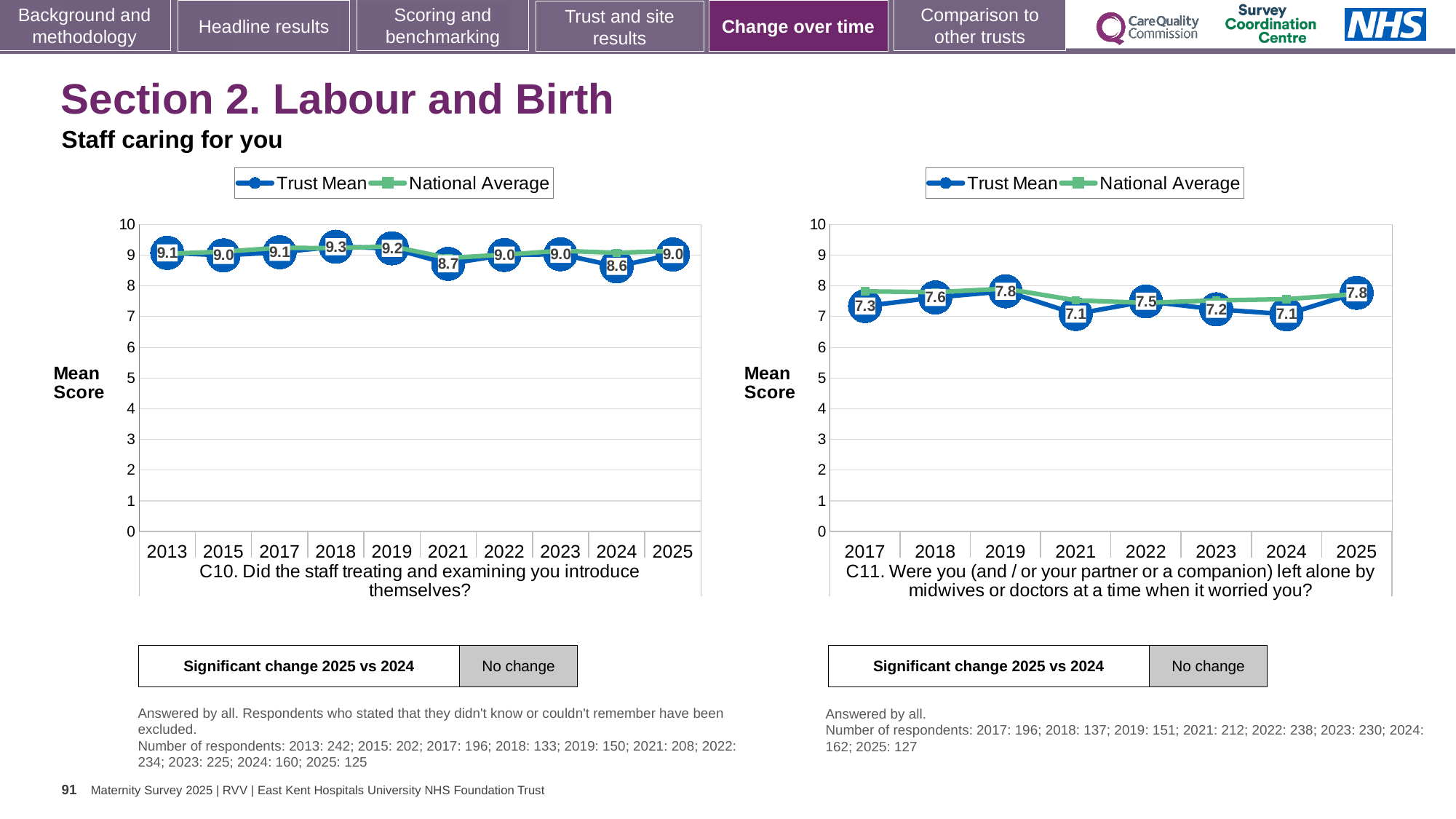
How many series does the legend of the C10 chart on the left list? 2 In the C10 chart on the left, which year has the lowest Trust Mean score? 2024 In the C11 chart on the right, what is the Trust Mean score for 2025? 7.8 In the C10 chart on the left, which year has the highest Trust Mean score? 2018 In the C10 chart on the left, what is the difference between the Trust Mean scores for 2018 and 2024? 0.7 In the C11 chart on the right, which is larger, the Trust Mean score for 2018 or for 2021? 2018 How many years are shown on the x axis of the C11 chart on the right? 8 In the C10 chart on the left, what is the Trust Mean score for 2018? 9.3 What kind of chart is the C10 chart on the left? Line chart In the C11 chart on the right, what is the Trust Mean score for 2021? 7.1 In the C10 chart on the left, what is the Trust Mean score for 2024? 8.6 In the C11 chart on the right, is the National Average value for 2017 greater or less than 7? greater